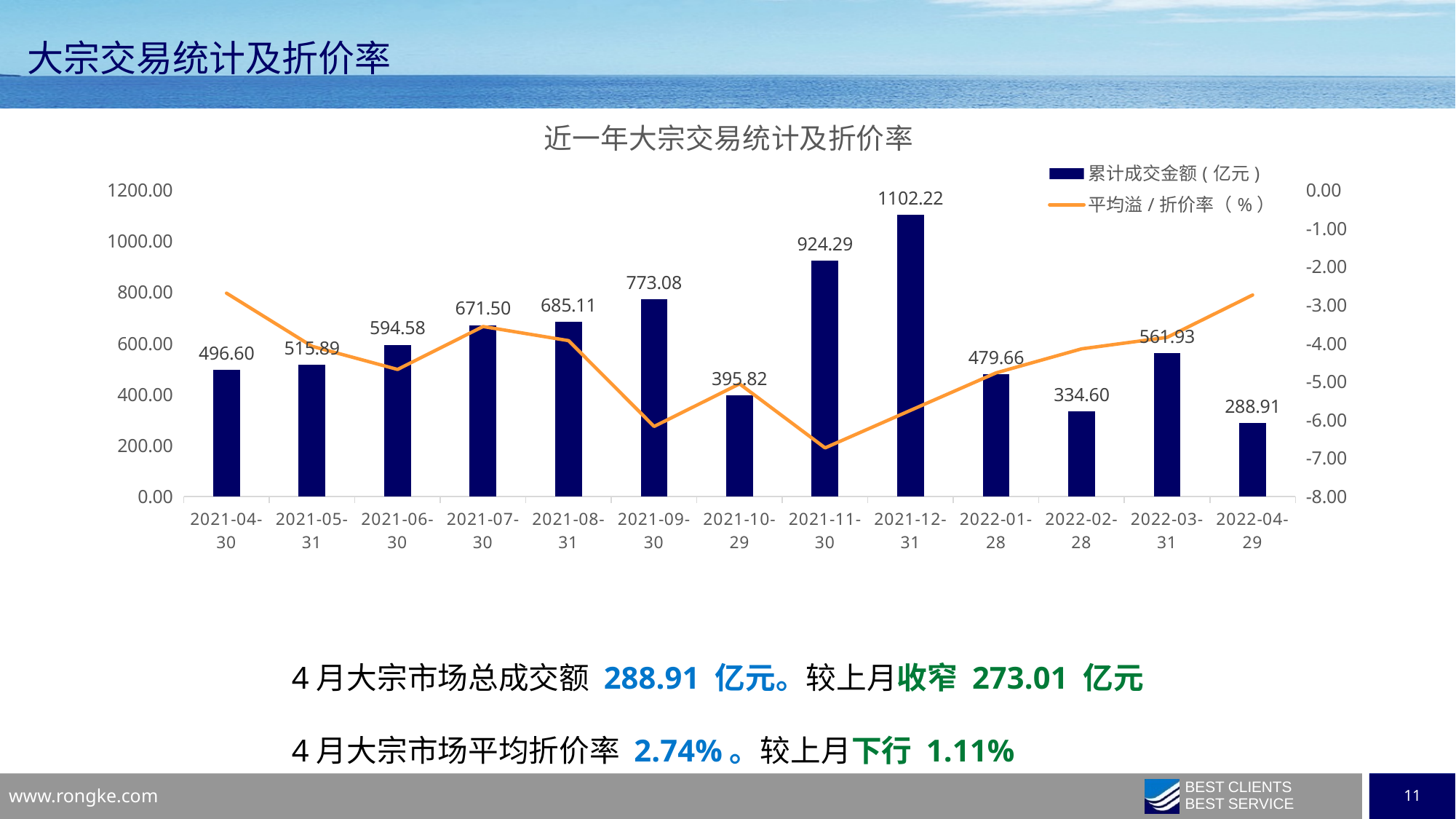
Which month has the highest 累计成交金额? 2021-12-31 What is the 累计成交金额 (亿元) for 2022-04-29? 288.91 Do the 累计成交金额 bars rise or fall from 2021-12-31 to 2022-02-28? fall Which month has the lowest 累计成交金额? 2022-04-29 What is the difference in 累计成交金额 between 2021-12-31 and 2021-11-30? 177.93 How many months are shown on the x axis? 13 How many series does the legend list? 2 Which has a larger 累计成交金额, 2021-09-30 or 2022-01-28? 2021-09-30 Is the 平均溢/折价率 (%) for 2021-11-30 greater or less than -6.00? less What is the 累计成交金额 (亿元) for 2021-10-29? 395.82 What kind of chart is this? Combined bar and line chart What is the 累计成交金额 (亿元) for 2021-12-31? 1102.22